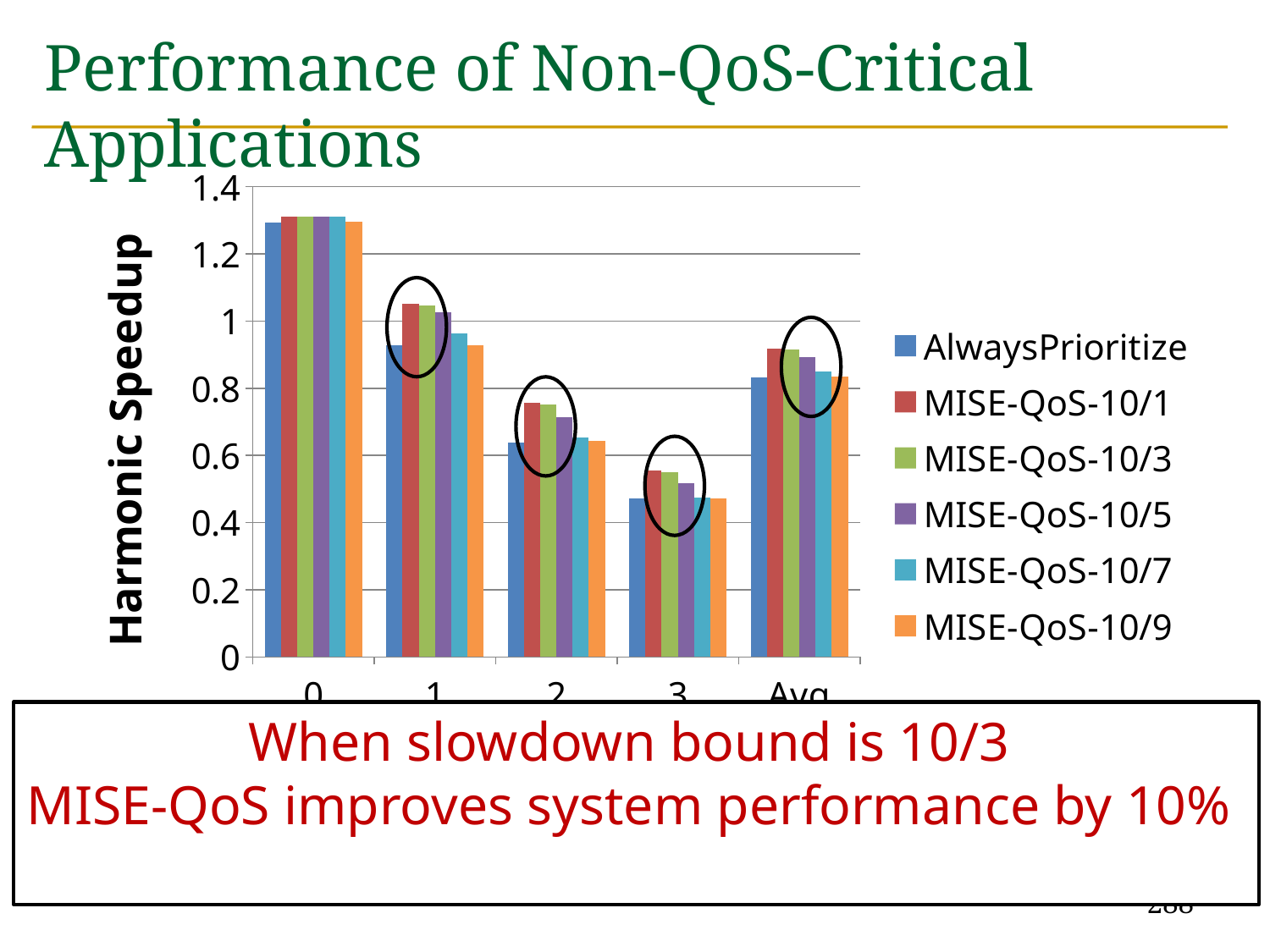
What kind of chart is shown on the slide? bar chart For the AlwaysPrioritize series, which category has the highest bar? 0 In category 1, which is larger: AlwaysPrioritize or MISE-QoS-10/1? MISE-QoS-10/1 Is the value for AlwaysPrioritize in category 0 greater or less than 1.2? greater For the AlwaysPrioritize series, which category has the lowest bar? 3 How many categories are shown along the x axis? 5 Is the value for MISE-QoS-10/9 in the Avg category greater or less than 1? less Is the value for MISE-QoS-10/1 in category 2 greater or less than 0.6? greater How many series does the legend list? 6 What is the title of the y axis? Harmonic Speedup Do the AlwaysPrioritize values rise or fall from category 0 to category 3? fall